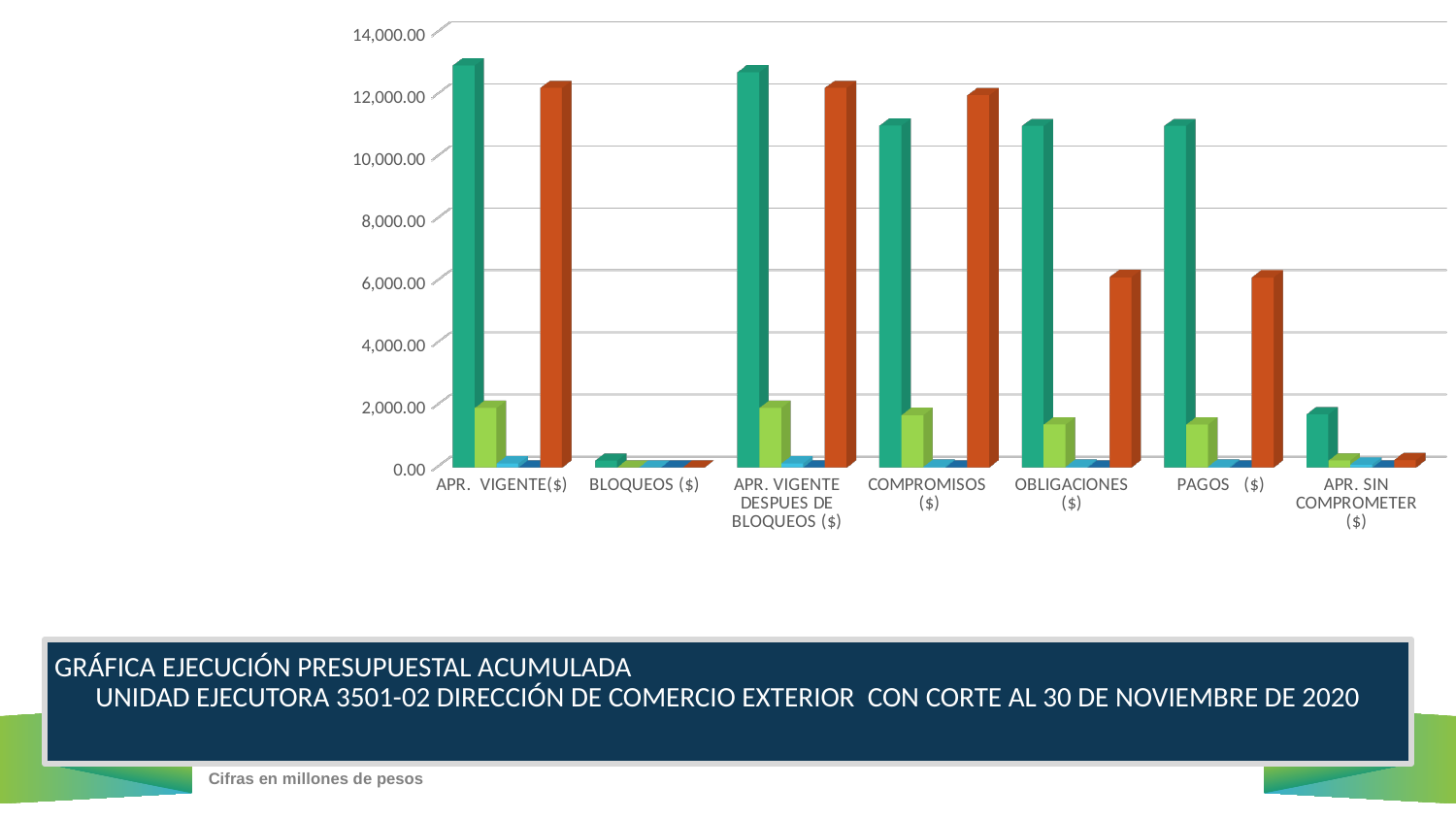
Which category has the lowest teal bar? BLOQUEOS ($) What kind of chart is shown on the slide? bar chart Which is larger, the orange bar for COMPROMISOS ($) or the orange bar for OBLIGACIONES ($)? COMPROMISOS ($) Is the value of the teal bar for APR. SIN COMPROMETER ($) greater or less than 4,000.00? less Is the value of the green bar for APR. VIGENTE($) greater or less than 4,000.00? less Is the value of the teal bar for APR. VIGENTE($) greater or less than 12,000.00? greater What is the highest value shown on the vertical axis of the chart? 14,000.00 How many categories are shown along the x axis of the chart? 7 For OBLIGACIONES ($), which is larger, the teal bar or the orange bar? the teal bar What is the first line of the title text shown below the chart? GRÁFICA EJECUCIÓN PRESUPUESTAL ACUMULADA